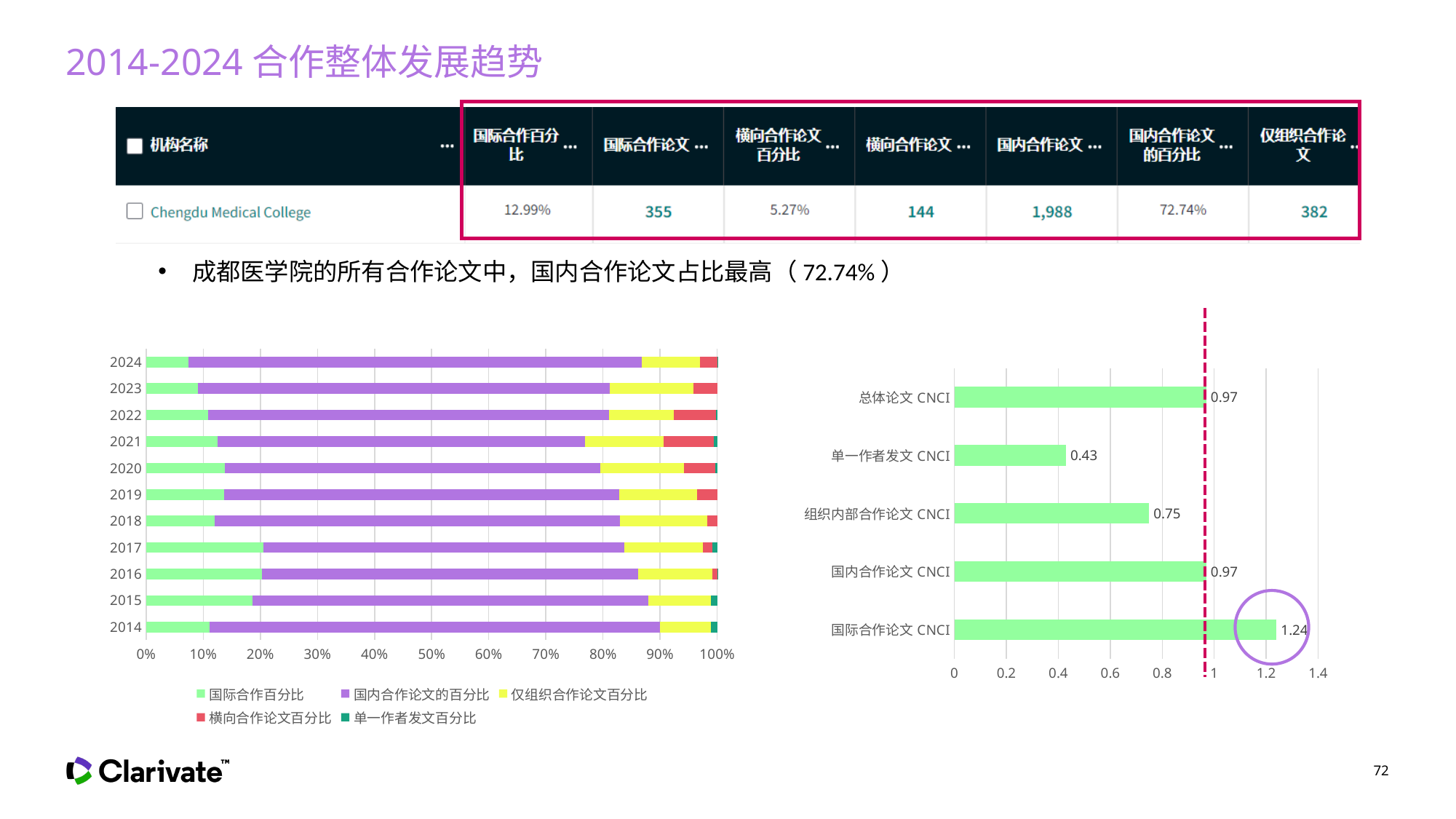
In the right chart, how many categories are plotted? 5 In the right chart, which is larger: 组织内部合作论文 CNCI or 国内合作论文 CNCI? 国内合作论文 CNCI What kind of chart is the left chart showing years 2014 to 2024? Stacked bar chart In the right chart, which category has the lowest CNCI value? 单一作者发文 CNCI In the right chart, what is the value for 单一作者发文 CNCI? 0.43 In the right chart, what is the value for 国际合作论文 CNCI? 1.24 In the right chart, which category has the highest CNCI value? 国际合作论文 CNCI In the right chart, what is the value for 组织内部合作论文 CNCI? 0.75 In the left chart, is the 国际合作百分比 value for 2024 greater or less than 10%? less In the left chart, how many series does the legend list? 5 In the left chart, which colour represents 国内合作论文的百分比? Purple In the right chart, what is the difference between the 国际合作论文 CNCI value and the 总体论文 CNCI value? 0.27